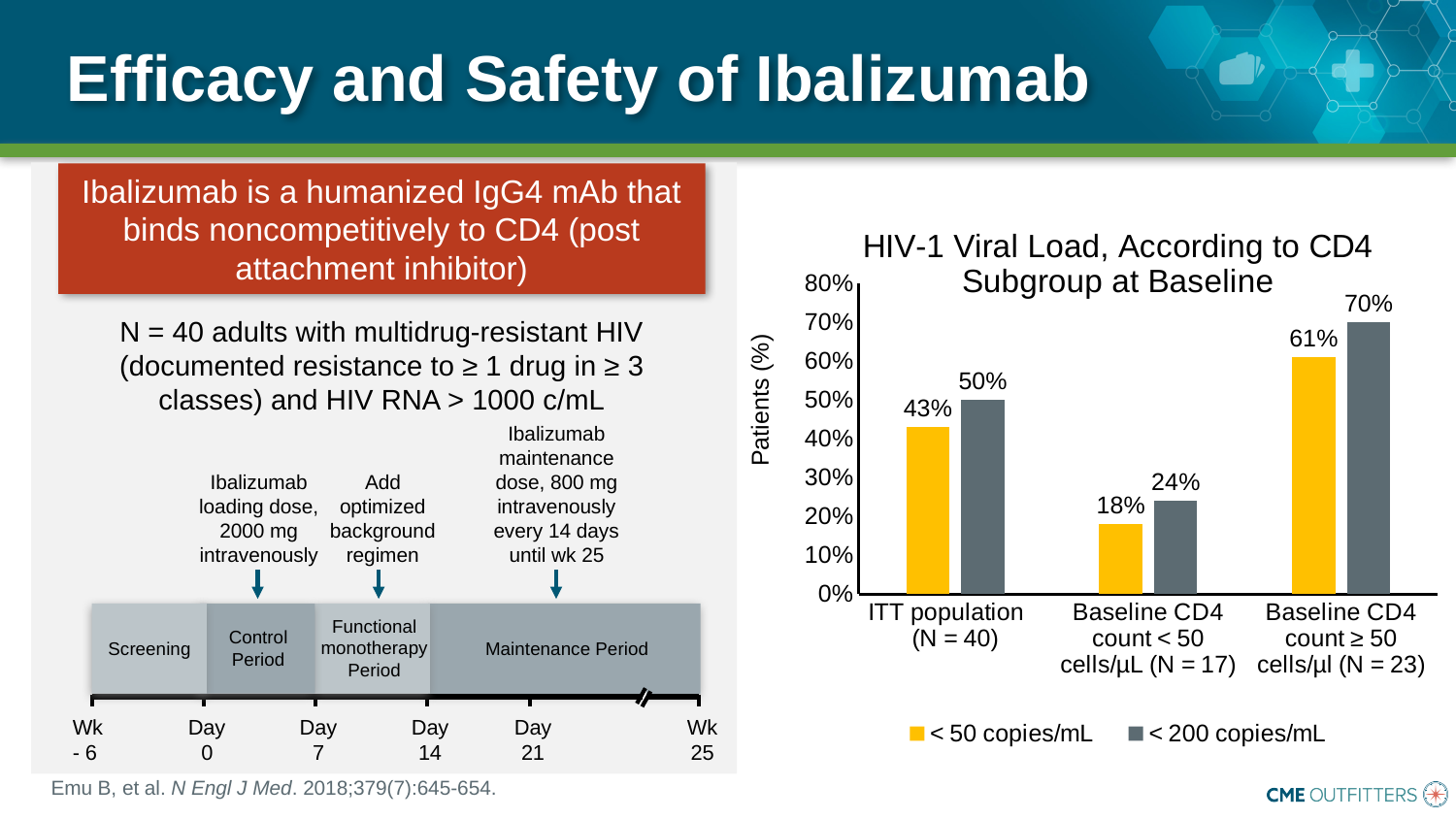
What is the difference between the < 200 copies/mL and < 50 copies/mL values in the ITT population (N = 40)? 7% Which category has the lowest value for < 50 copies/mL? Baseline CD4 count < 50 cells/µL (N = 17) How many series does the chart legend list? 2 Which category has the highest value for < 200 copies/mL? Baseline CD4 count ≥ 50 cells/µl (N = 23) What is the value for < 50 copies/mL in the ITT population (N = 40)? 43% What is the value for < 50 copies/mL in the Baseline CD4 count < 50 cells/µL (N = 17) group? 18% Which is larger: the < 50 copies/mL value in the ITT population or the < 200 copies/mL value in the Baseline CD4 count < 50 group? < 50 copies/mL in the ITT population What is the value for < 200 copies/mL in the Baseline CD4 count ≥ 50 cells/µl (N = 23) group? 70% What is the difference between the < 50 copies/mL values for the Baseline CD4 count ≥ 50 group and the Baseline CD4 count < 50 group? 43% How many categories are shown on the x axis of the chart? 3 What is the title of the chart? HIV-1 Viral Load, According to CD4 Subgroup at Baseline What kind of chart is shown on the slide? Bar chart